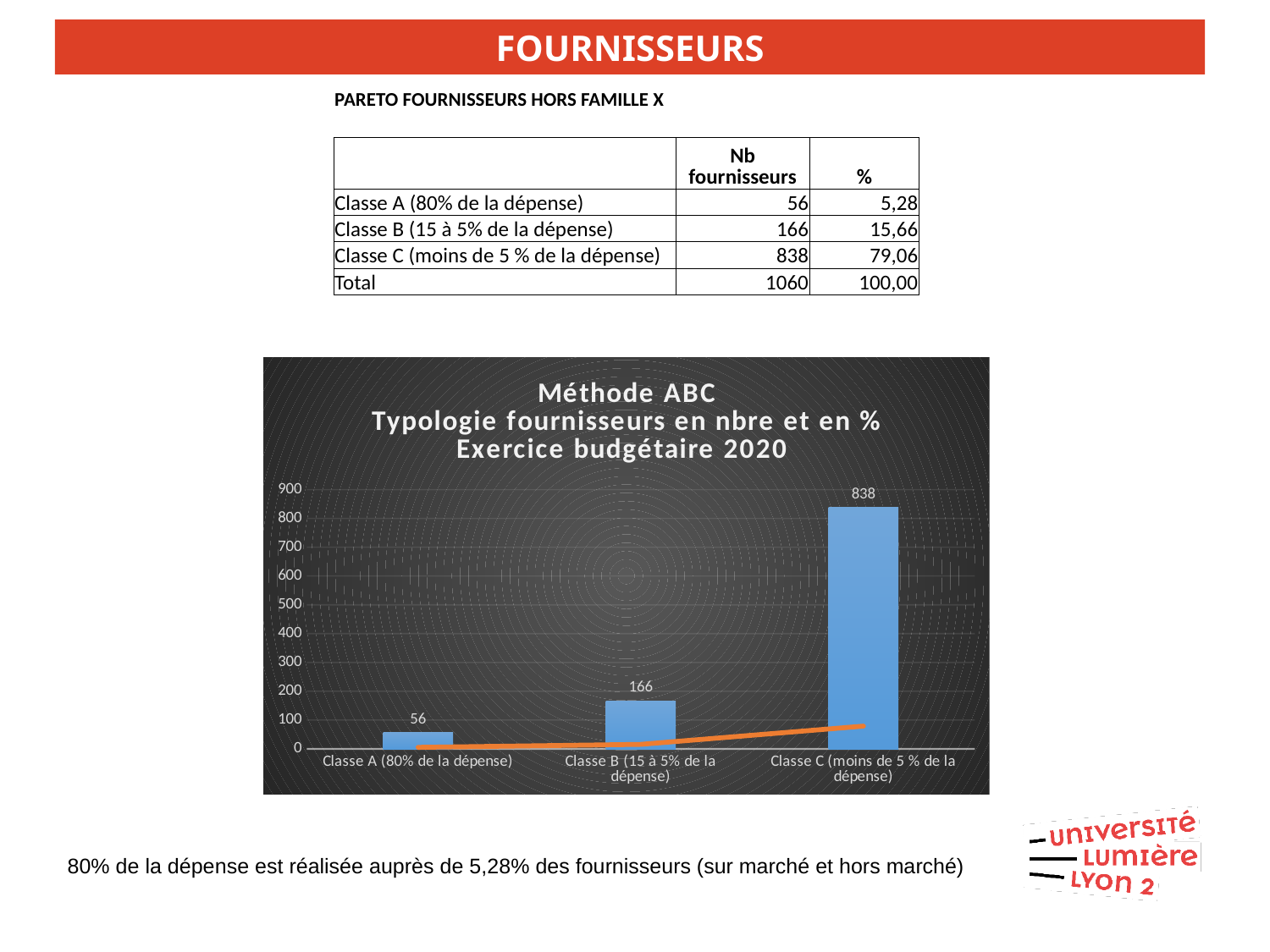
Which category has the lowest bar in the chart? Classe A (80% de la dépense) What kind of chart is shown on the slide? Combination bar and line chart What is the value shown for Classe A (80% de la dépense) in the chart? 56 What is the difference between the values for Classe B and Classe A in the chart? 110 Is the value for Classe C greater or less than 800? greater What is the difference between the values for Classe C and Classe B in the chart? 672 Which category has the highest bar in the chart? Classe C (moins de 5 % de la dépense) What is the value shown for Classe B (15 à 5% de la dépense) in the chart? 166 How many categories are shown on the x axis of the chart? 3 Do the bar values rise or fall from Classe A to Classe C along the x axis? Rise What is the value shown for Classe C (moins de 5 % de la dépense) in the chart? 838 Which is larger in the chart, the value for Classe A or the value for Classe B? Classe B